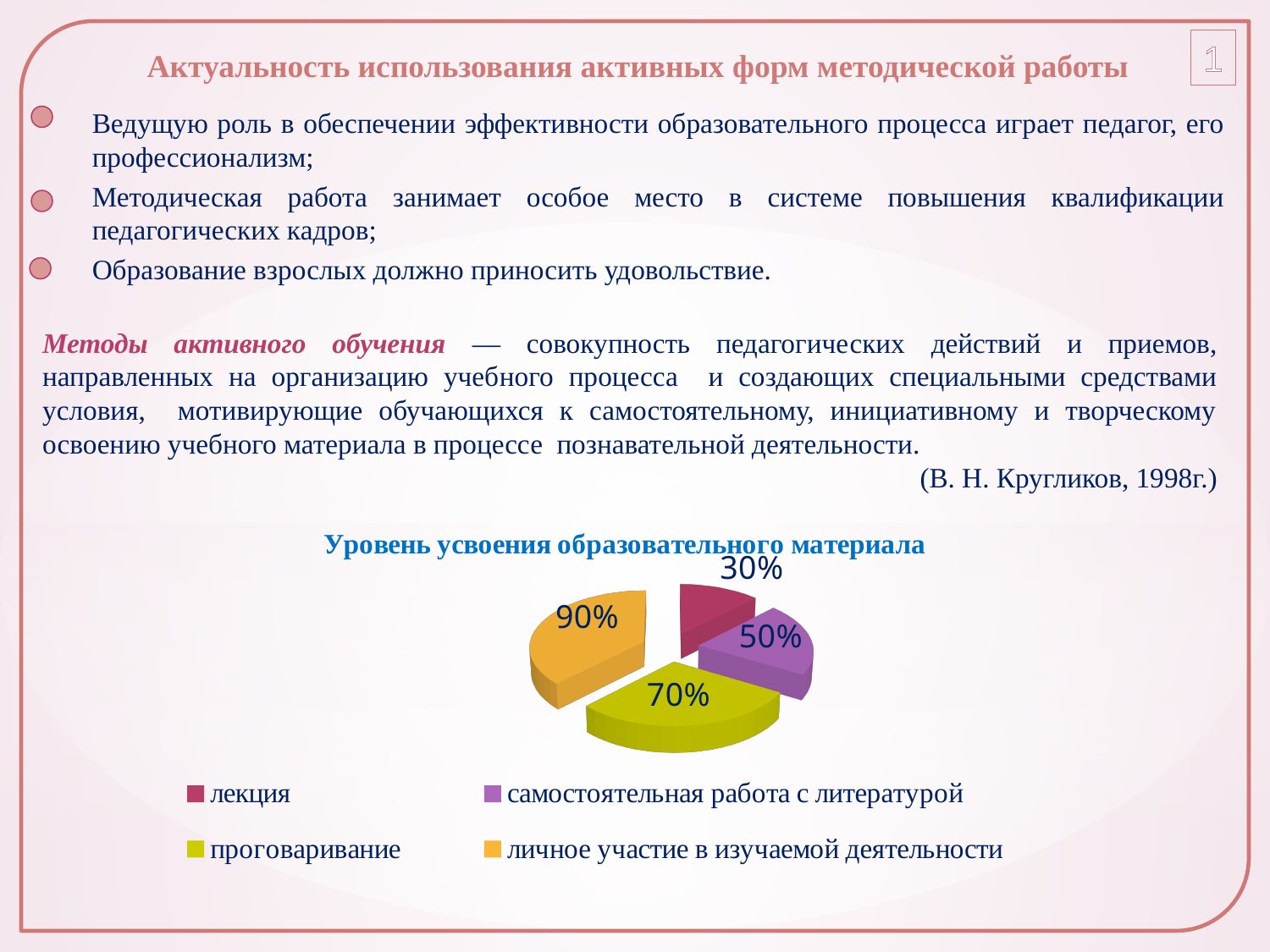
What is the difference between the values for личное участие в изучаемой деятельности and лекция? 60% What is the title of the chart? Уровень усвоения образовательного материала Which is larger, the value for проговаривание or the value for самостоятельная работа с литературой? проговаривание What value is shown for лекция? 30% Which category has the lowest value? лекция What value is shown for самостоятельная работа с литературой? 50% What value is shown for личное участие в изучаемой деятельности? 90% What value is shown for проговаривание? 70% How many categories does the pie chart have? 4 Which category has the highest value? личное участие в изучаемой деятельности What type of chart is shown on the slide? pie chart What colour is the slice for проговаривание? yellow-green